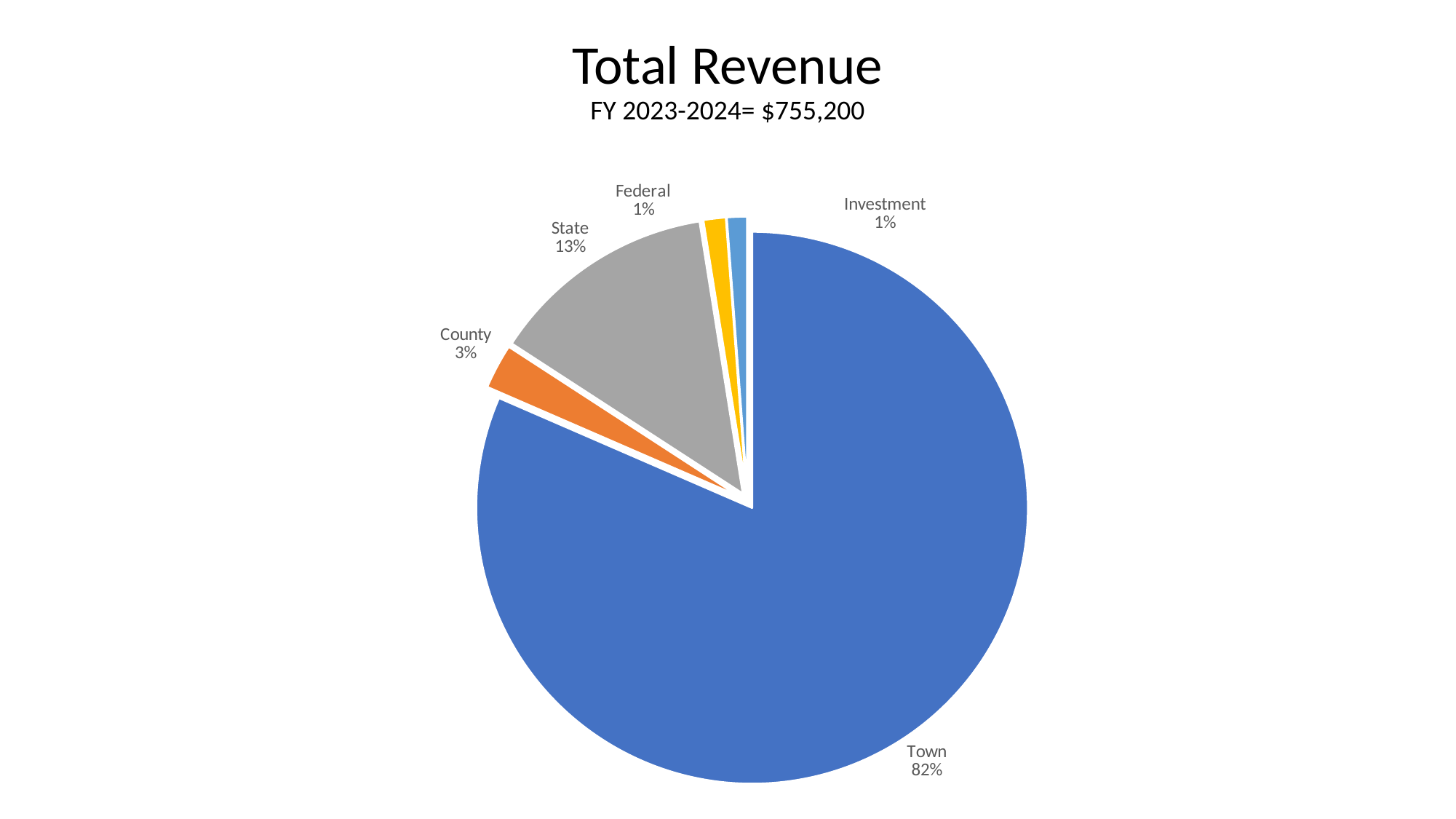
What is the combined share of State and County? 16% Which revenue source has the largest slice of the pie? Town What share of total revenue comes from Federal? 1% Which is larger, the State slice or the County slice? State What total revenue amount is shown for FY 2023-2024? $755,200 What kind of chart is shown on the slide? pie chart What share of total revenue comes from County? 3% What is the difference in percentage points between the Town share and the State share? 69 What share of total revenue comes from State? 13% How many slices does the pie chart have? 5 What is the title of the chart? Total Revenue